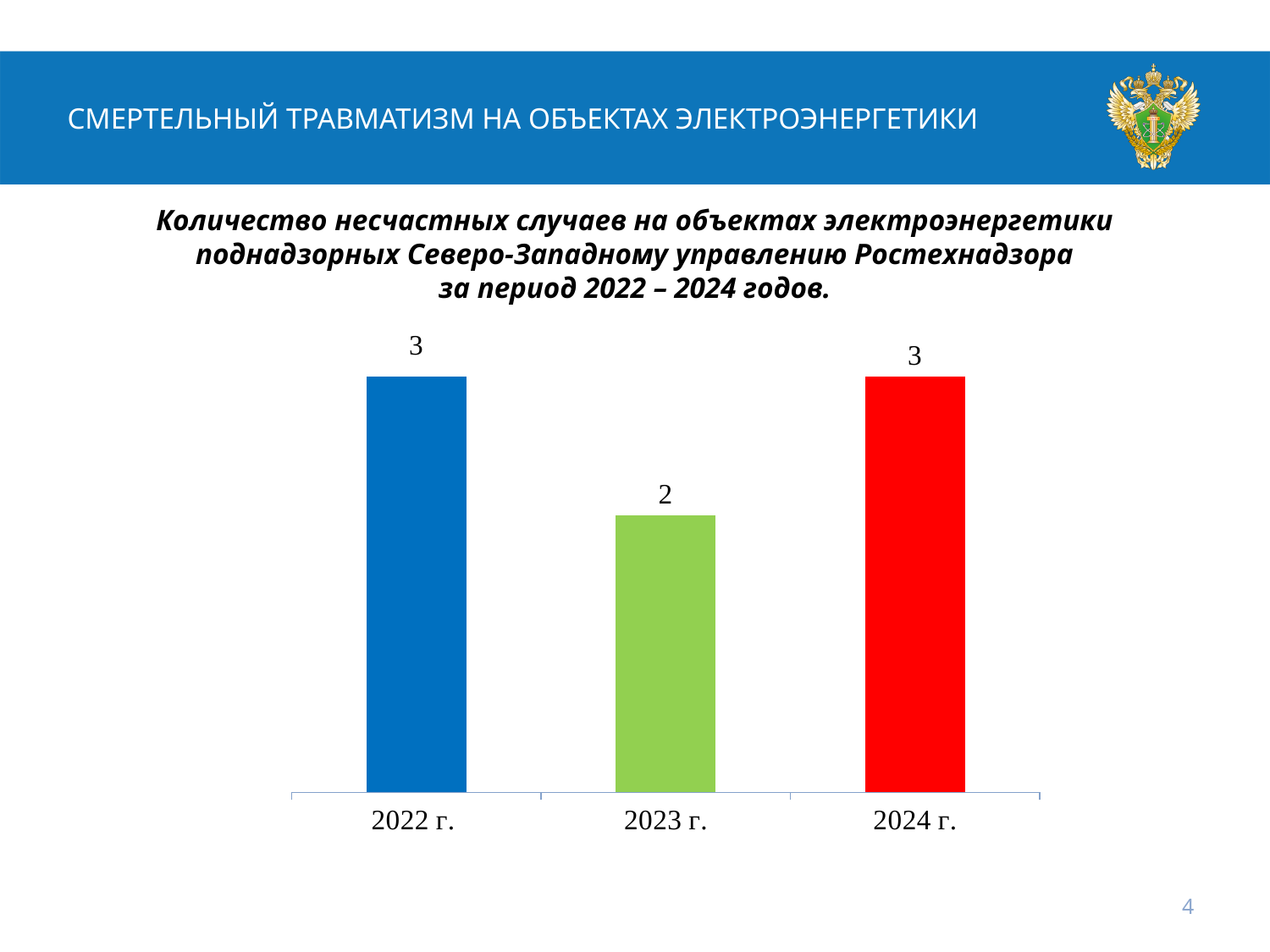
What colour is the bar for 2024 г.? red What is the value for 2022 г.? 3 What is the value for 2024 г.? 3 What is the value for 2023 г.? 2 What colour is the bar for 2023 г.? green Which is larger, the value for 2023 г. or the value for 2024 г.? 2024 г. What kind of chart is shown on the slide? bar chart How many categories are shown on the x axis? 3 Does the value rise or fall from 2023 г. to 2024 г.? rise Does the value rise or fall from 2022 г. to 2023 г.? fall Which year has the lowest value? 2023 г. What is the difference between the values for 2022 г. and 2023 г.? 1